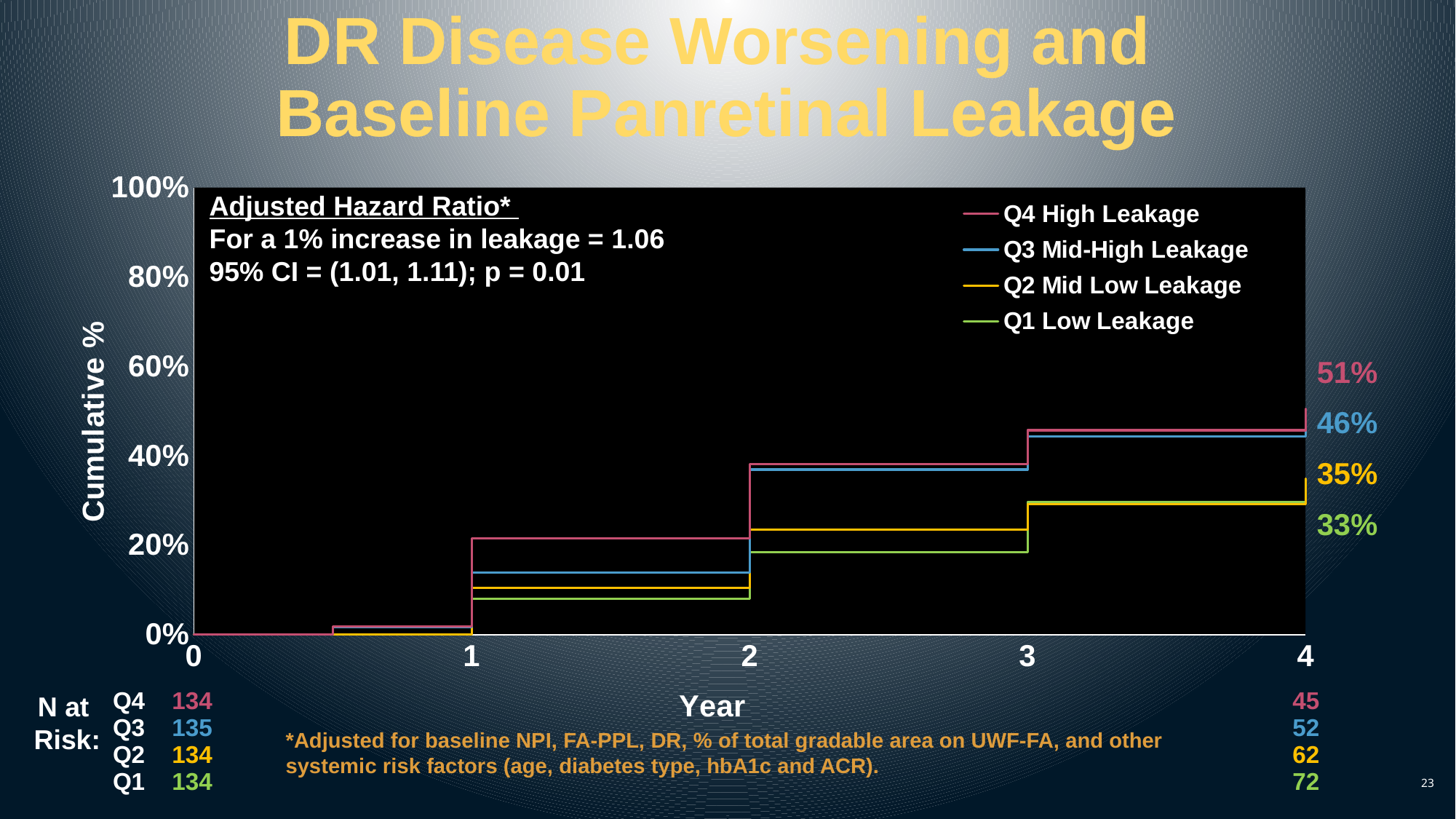
Which series has the highest cumulative % at year 4? Q4 High Leakage What is the difference between the year-4 cumulative % of Q4 High Leakage and Q1 Low Leakage? 18% What kind of chart is shown on the slide? Line chart (step curve) Which series has the lowest cumulative % at year 4? Q1 Low Leakage What is the cumulative % for Q3 Mid-High Leakage at year 4? 46% Is the cumulative % for Q4 High Leakage at year 2 greater or less than 20%? greater How many series does the legend list? 4 What is the cumulative % for Q4 High Leakage at year 4? 51% What is the cumulative % for Q2 Mid Low Leakage at year 4? 35% What is the cumulative % for Q1 Low Leakage at year 4? 33% Do the cumulative % values rise or fall as the year increases? Rise Which is larger at year 4: the cumulative % for Q3 Mid-High Leakage or Q2 Mid Low Leakage? Q3 Mid-High Leakage